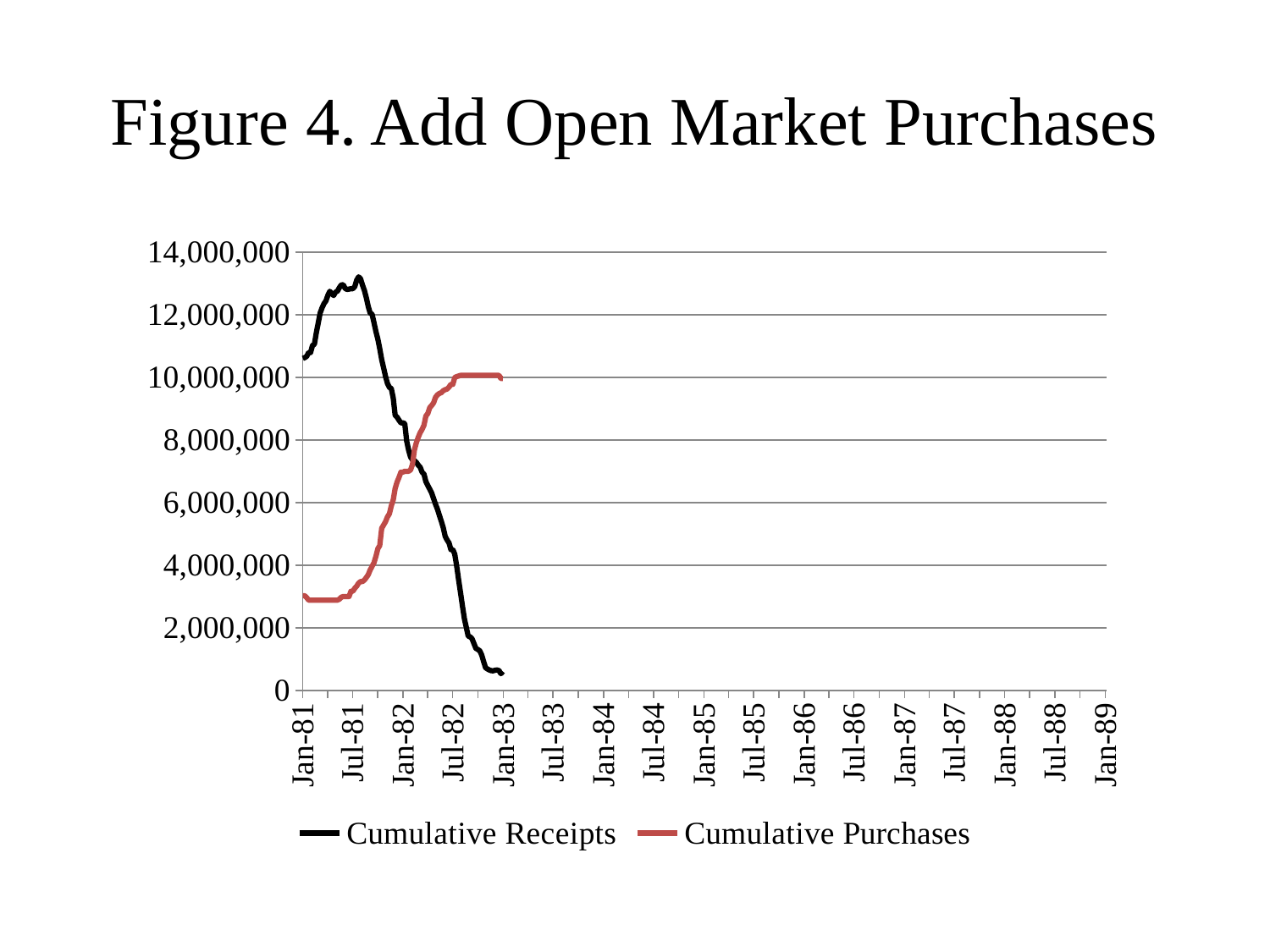
Is the value for Cumulative Purchases at Jan-83 greater or less than 8,000,000? greater Does the Cumulative Receipts line rise or fall between Jul-81 and Jan-83? fall At Jan-81, which series has the higher value, Cumulative Receipts or Cumulative Purchases? Cumulative Receipts At Jul-82, which series has the higher value, Cumulative Receipts or Cumulative Purchases? Cumulative Purchases How many series does the legend list? 2 Is the value for Cumulative Purchases at Jan-81 greater or less than 4,000,000? less Is the value for Cumulative Receipts at Jan-83 greater or less than 2,000,000? less What is the title of the chart? Figure 4. Add Open Market Purchases Does the Cumulative Purchases line rise or fall between Jan-81 and Jul-82? rise What colour is the Cumulative Purchases line? red What kind of chart is shown on the slide? line chart